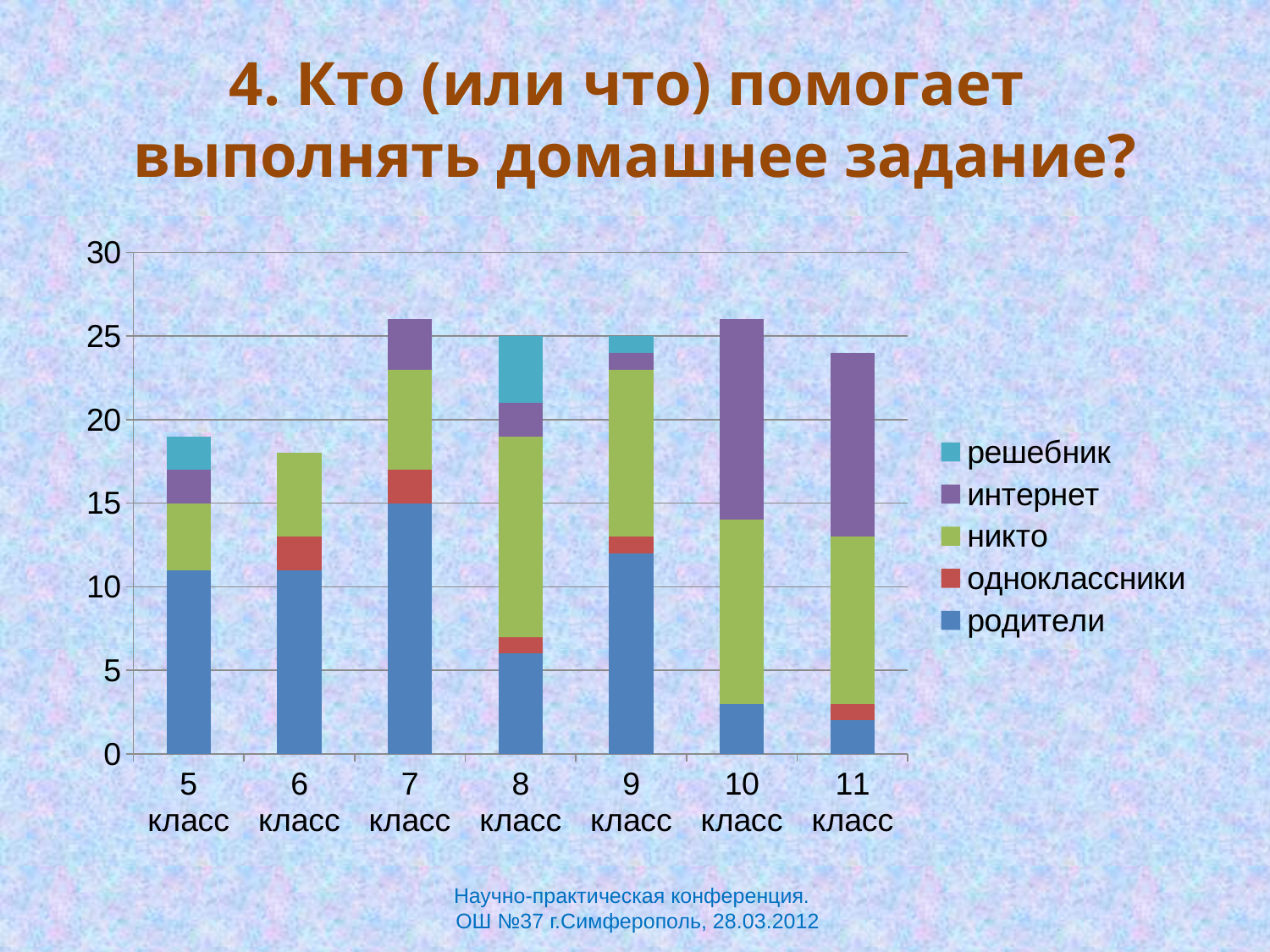
How many classes (categories) are shown on the x axis? 7 Is the total for 5 класс greater or less than 20? less Is the total for 10 класс greater or less than 25? greater Which class has the largest родители segment? 7 класс What is the total height of the stacked bar for 8 класс? 25 Is the родители segment for 11 класс greater or less than 5? less What is the total height of the stacked bar for 9 класс? 25 What kind of chart is shown on the slide? stacked bar chart Which is larger: the интернет segment for 10 класс or for 5 класс? 10 класс Which series is listed first in the legend? решебник What is the value of the родители segment for 7 класс? 15 How many series does the legend list? 5